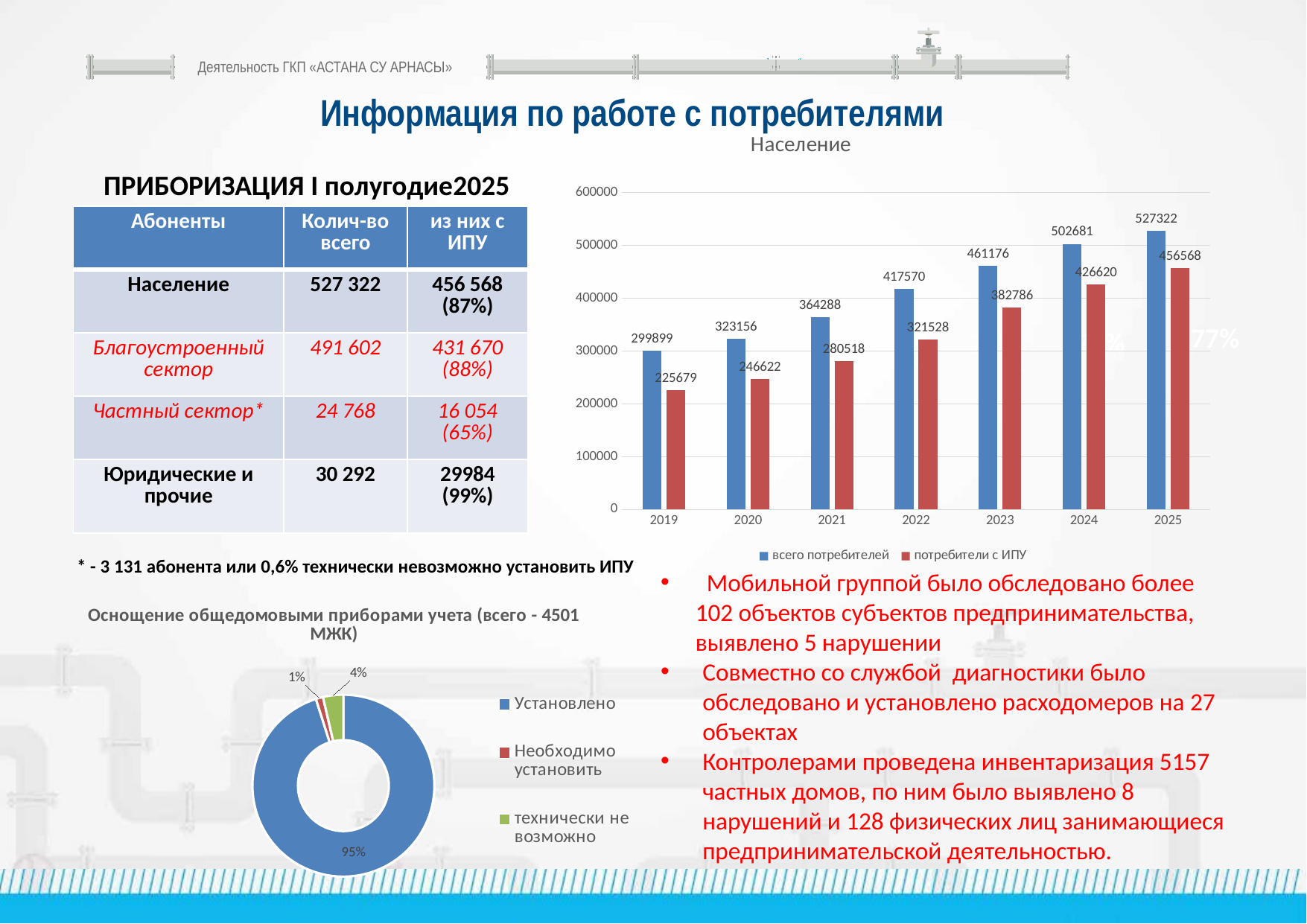
In the "Население" chart, how many years are shown on the x axis? 7 In the "Население" chart, what is the value for "потребители с ИПУ" in 2019? 225679 In the "Население" chart, what is the difference between "всего потребителей" and "потребители с ИПУ" in 2024? 76061 In the "Население" chart, what is the value for "всего потребителей" in 2025? 527322 What kind of chart is the "Оснащение общедомовыми приборами учета" chart at the bottom left? doughnut chart In the "Население" chart, how many series does the legend list? 2 In the "Оснащение общедомовыми приборами учета" chart, what share does "Установлено" have? 95% In the "Население" chart, which year has the lowest value for "потребители с ИПУ"? 2019 In the "Население" chart, do the values for "всего потребителей" rise or fall from 2019 to 2025? rise In the "Население" chart, which is larger: "потребители с ИПУ" in 2023 or "всего потребителей" in 2021? потребители с ИПУ in 2023 In the "Население" chart, what is the value for "потребители с ИПУ" in 2022? 321528 In the "Население" chart, which year has the highest value for "всего потребителей"? 2025